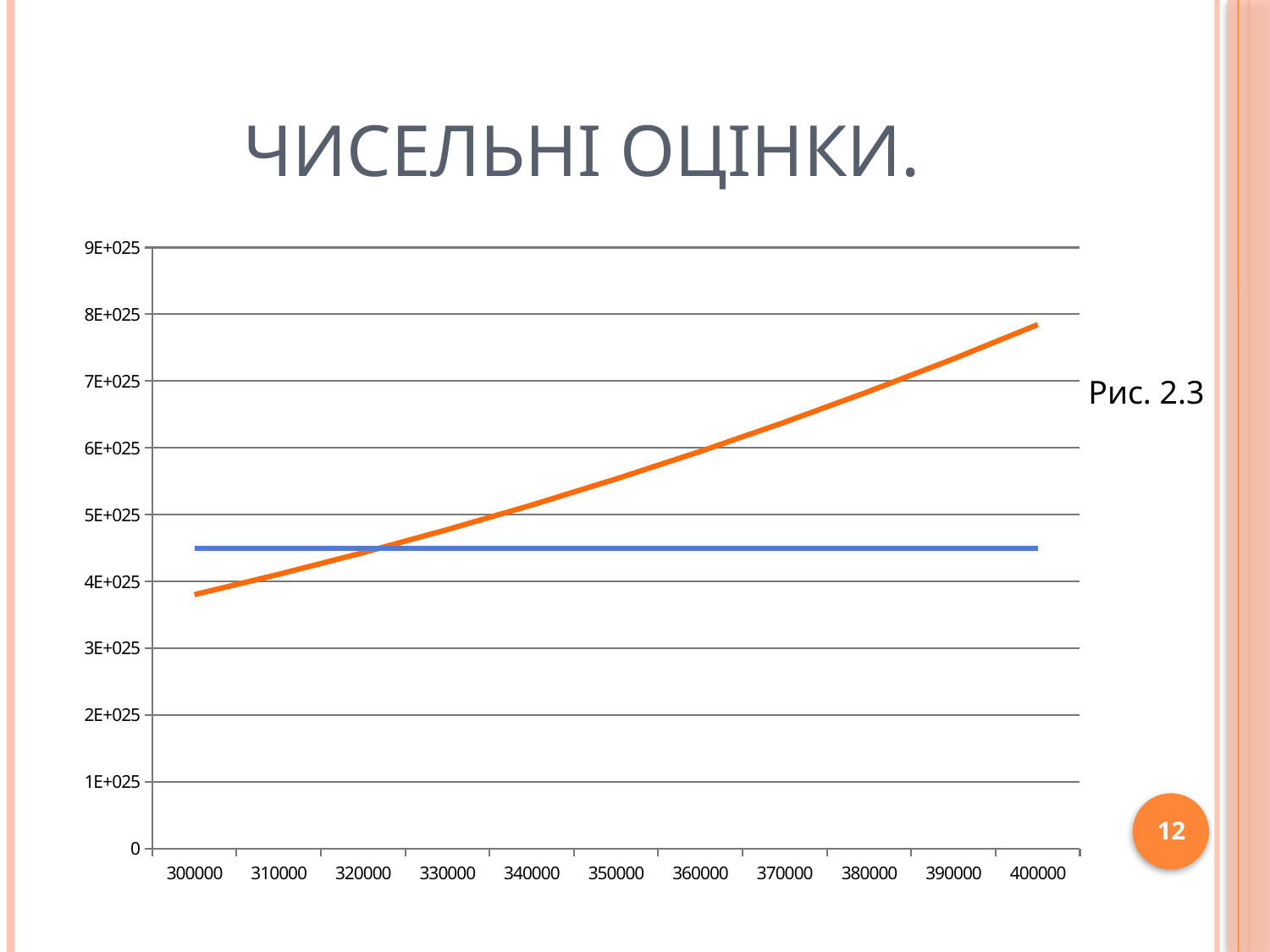
Does the blue line rise, fall, or stay flat across the x axis? stays flat Is the value of the orange line at 400000 greater or less than 7E+025? greater Is the value of the blue line greater or less than 5E+025? less How many lines are plotted on the chart? 2 Is the value of the blue line greater or less than 4E+025? greater How many tick labels are shown on the x axis? 11 Does the orange line rise or fall as the x-axis value increases from 300000 to 400000? rises At x = 400000, which line has the higher value, the orange line or the blue line? the orange line What kind of chart is shown on the slide? line chart What is the figure label shown to the right of the chart? Рис. 2.3 At x = 300000, which line has the higher value, the orange line or the blue line? the blue line